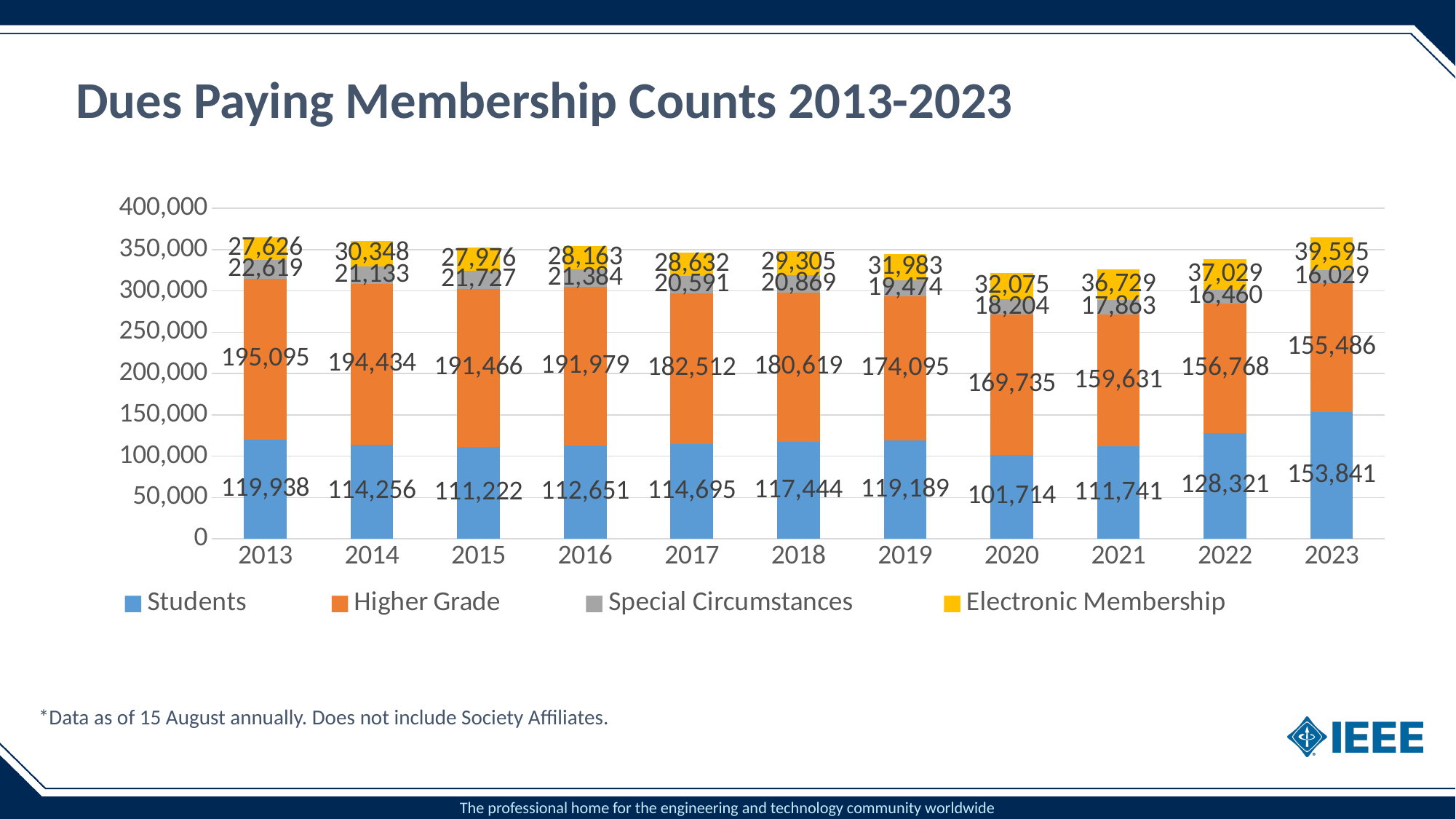
How many series does the legend list? 4 What is the Special Circumstances value for 2019? 19,474 Which year has the highest Students value? 2023 Which year has the lowest Students value? 2020 What is the Higher Grade value for 2017? 182,512 Do the Higher Grade values rise or fall from 2013 to 2023? fall How many years are shown on the x axis? 11 Is the Higher Grade value larger in 2013 or in 2023? 2013 What is the Electronic Membership value for 2021? 36,729 Which year has the highest Higher Grade value? 2013 What is the Students value for 2023? 153,841 What is the difference between the Students value in 2023 and in 2013? 33,903